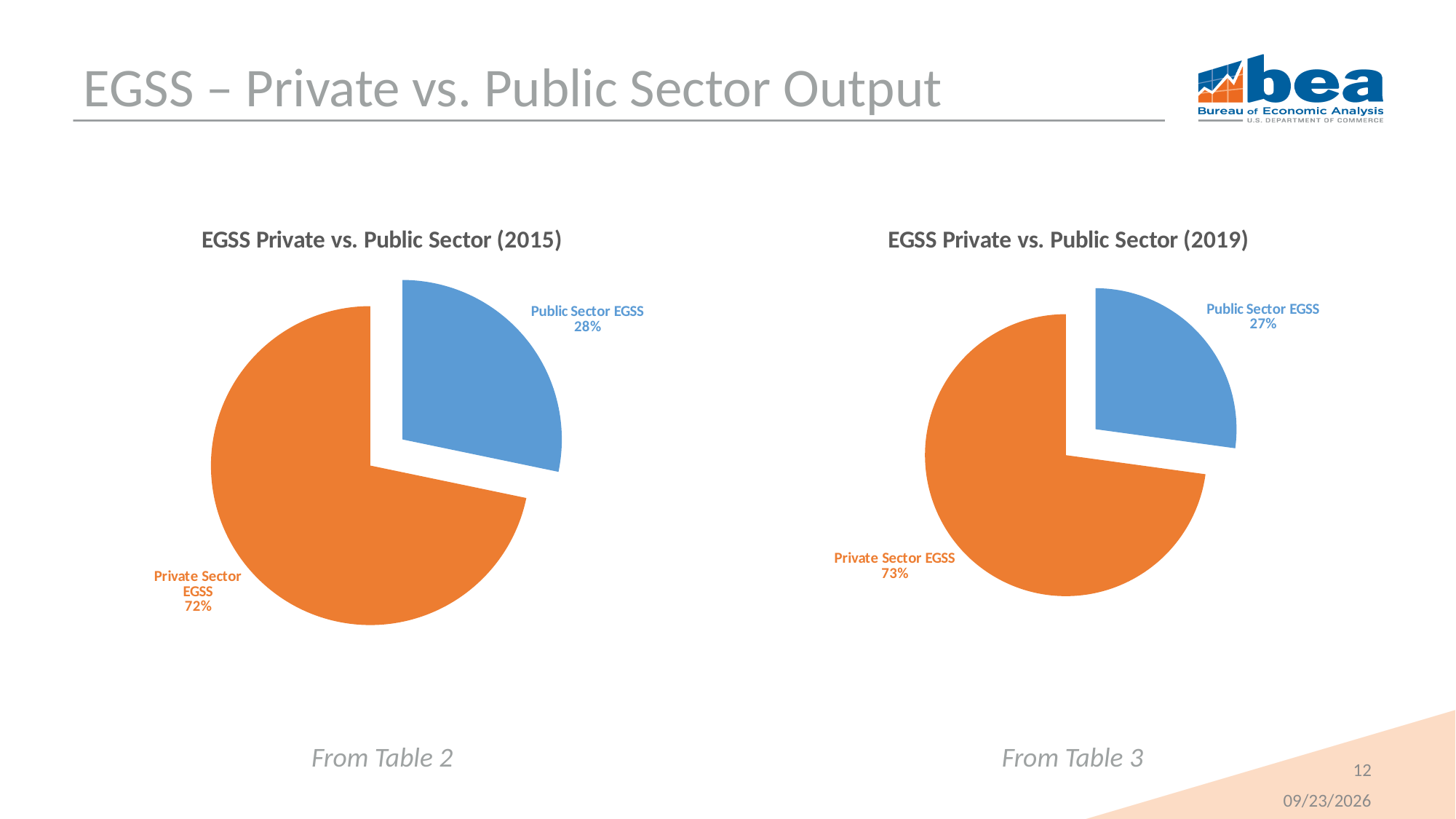
In the 'EGSS Private vs. Public Sector (2019)' chart, what share does Public Sector EGSS have? 27% In the 'EGSS Private vs. Public Sector (2015)' chart, what colour is the Public Sector EGSS slice? Blue In the 'EGSS Private vs. Public Sector (2015)' chart, what share does Private Sector EGSS have? 72% In the 'EGSS Private vs. Public Sector (2019)' chart, which slice is the smallest? Public Sector EGSS In the 'EGSS Private vs. Public Sector (2015)' chart, what is the difference in percentage points between the Private Sector EGSS and Public Sector EGSS shares? 44 In the 'EGSS Private vs. Public Sector (2019)' chart, what share does Private Sector EGSS have? 73% How many slices does the 'EGSS Private vs. Public Sector (2019)' chart have? 2 Which is larger: the Public Sector EGSS share in the 2015 chart or the Public Sector EGSS share in the 2019 chart? 2015 chart In the 'EGSS Private vs. Public Sector (2019)' chart, what is the difference in percentage points between the Private Sector EGSS and Public Sector EGSS shares? 46 In the 'EGSS Private vs. Public Sector (2015)' chart, which slice is the largest? Private Sector EGSS What kind of chart is the 'EGSS Private vs. Public Sector (2015)' chart? Pie chart